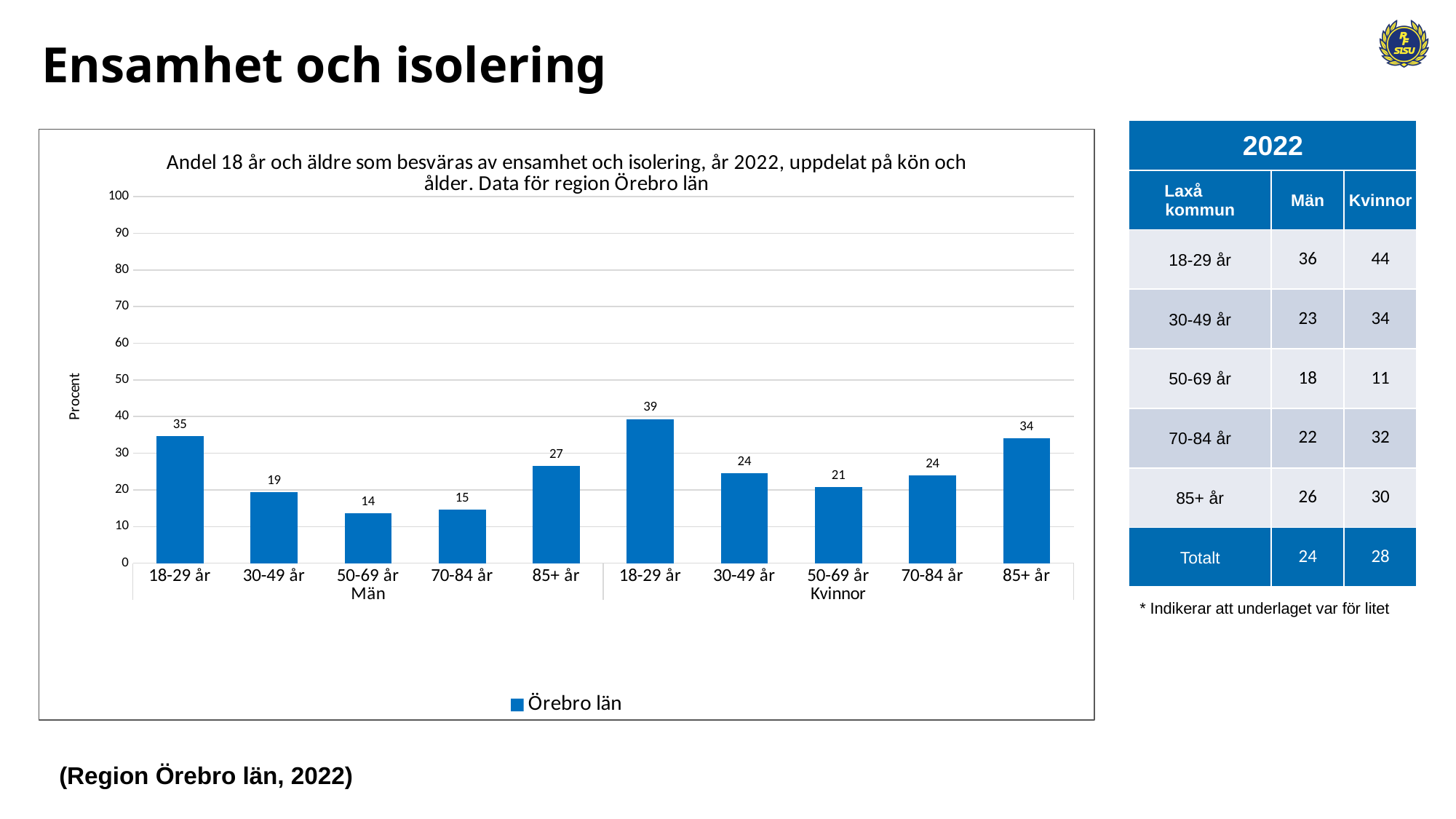
What is the difference between Kvinnor 18-29 år and Män 18-29 år? 4 Which bar has the lowest value? Män 50-69 år What is the value for Kvinnor aged 85+ år? 34 Which bar has the highest value? Kvinnor 18-29 år Is the value for Män 30-49 år greater or less than 20? less Which is larger: Män 85+ år or Kvinnor 85+ år? Kvinnor 85+ år How many series does the legend list? 1 What kind of chart is shown? bar chart What is the value for Män aged 18-29 år? 35 What is the legend entry of the chart? Örebro län What is the value for Kvinnor aged 50-69 år? 21 How many bars are plotted in the chart? 10